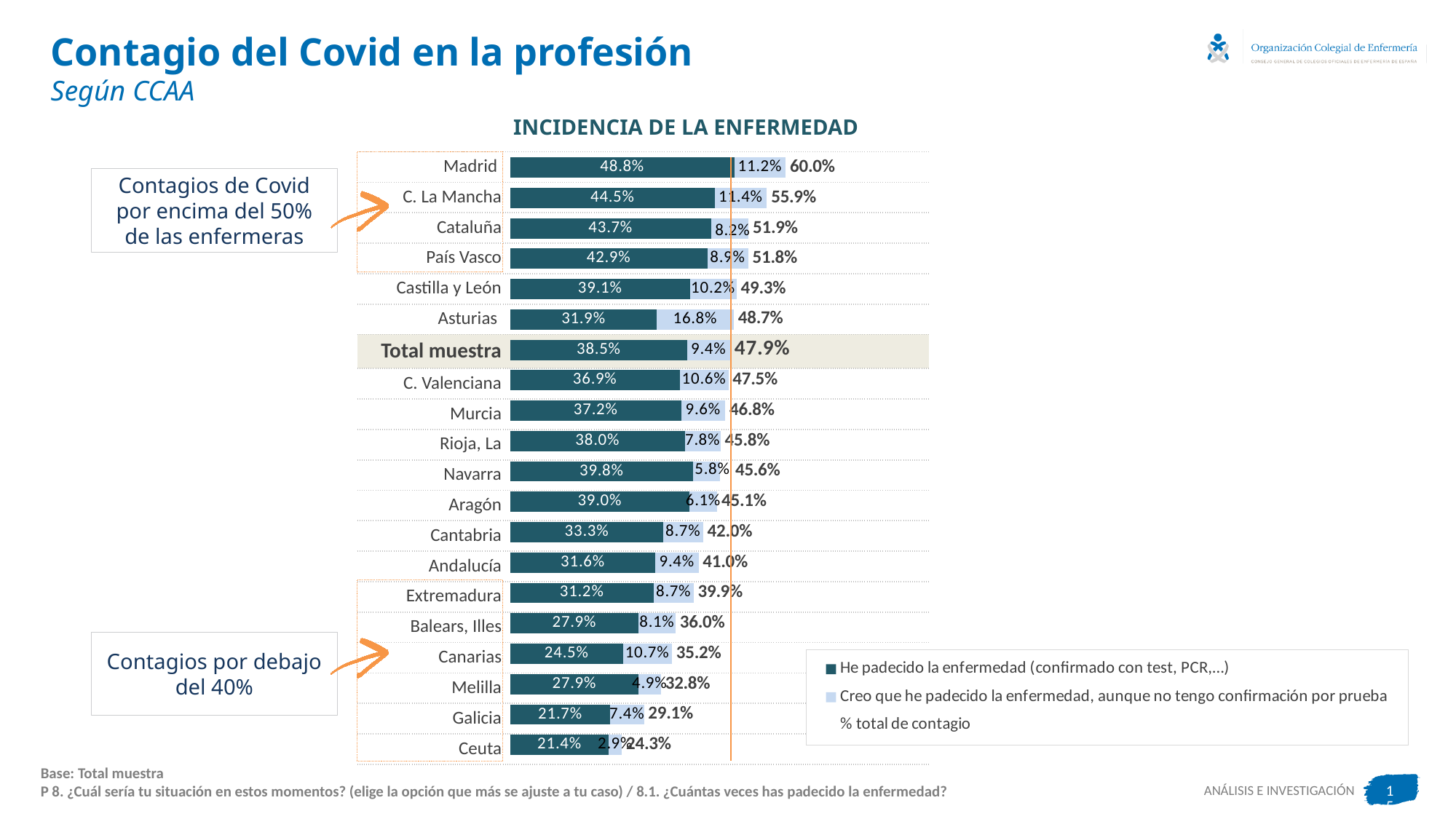
How many entries does the chart legend list? 3 What is the difference between the '% total de contagio' for Madrid and for Ceuta? 35.7% What is the 'He padecido la enfermedad (confirmado con test, PCR,...)' value for Asturias? 31.9% What is the 'Creo que he padecido la enfermedad, aunque no tengo confirmación por prueba' value for Canarias? 10.7% Which category has the highest '% total de contagio'? Madrid What is the '% total de contagio' value for Total muestra? 47.9% How many categories (rows) are plotted in the chart, including Total muestra? 20 Which category has the lowest '% total de contagio'? Ceuta Which has a larger 'He padecido la enfermedad (confirmado con test, PCR,...)' value, Navarra or Cantabria? Navarra What is the title of the chart? INCIDENCIA DE LA ENFERMEDAD What is the '% total de contagio' value for Madrid? 60.0% What type of chart is shown on the slide? Stacked horizontal bar chart